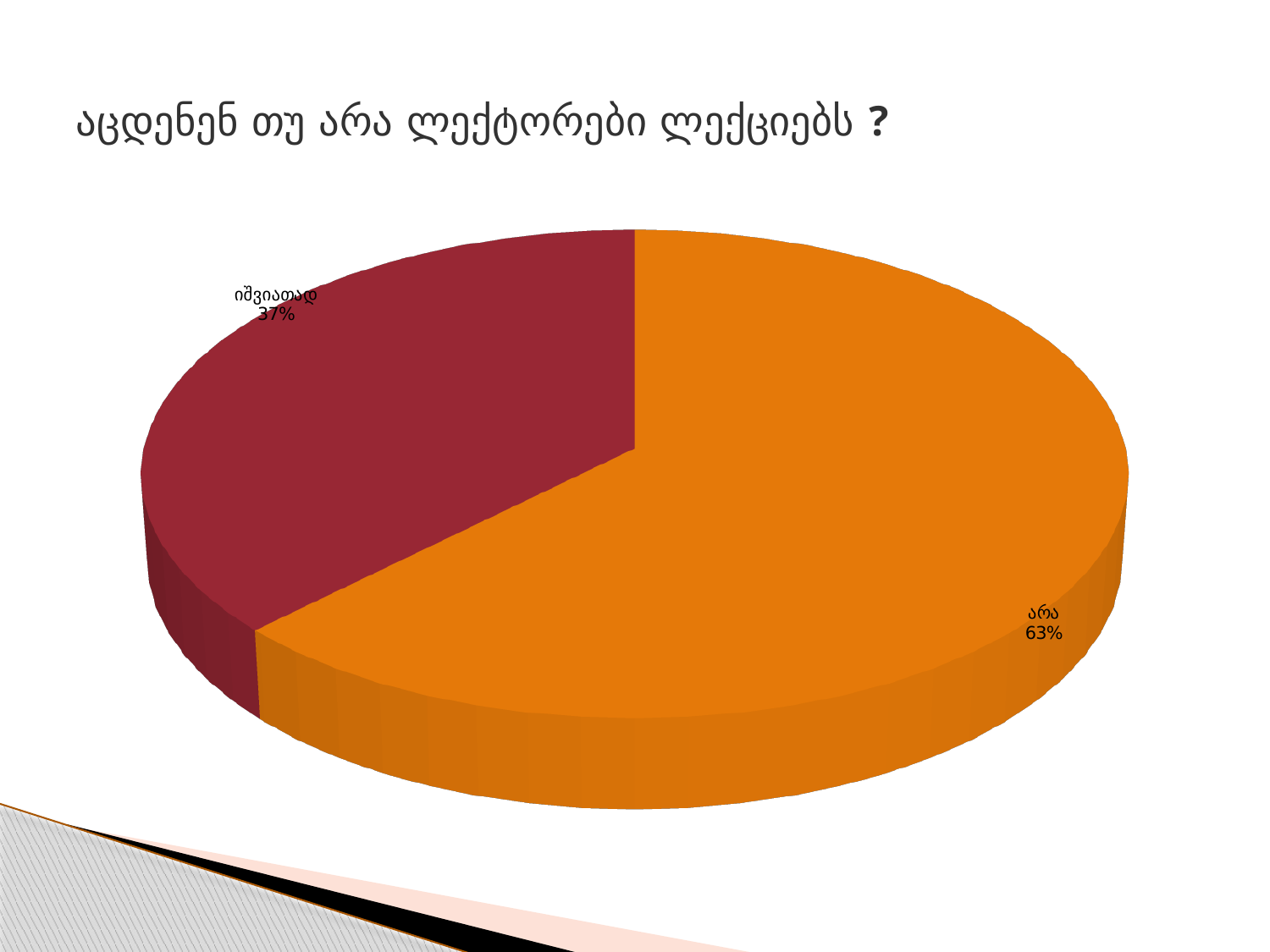
What percentage is shown for the slice labelled "არა"? 63% What kind of chart is shown on the slide? pie chart What percentage is shown for the slice labelled "იშვიათად"? 37% Which is larger, the "არა" slice or the "იშვიათად" slice? არა What share of the pie does the "არა" slice represent? 63% Which slice of the pie is the smallest? იშვიათად How many slices does the pie chart have? 2 What is the title of the slide above the pie chart? აცდენენ თუ არა ლექტორები ლექციებს ? What colour is the "იშვიათად" slice of the pie? dark red Which slice of the pie is the largest? არა What is the difference in percentage points between the "არა" slice and the "იშვიათად" slice? 26